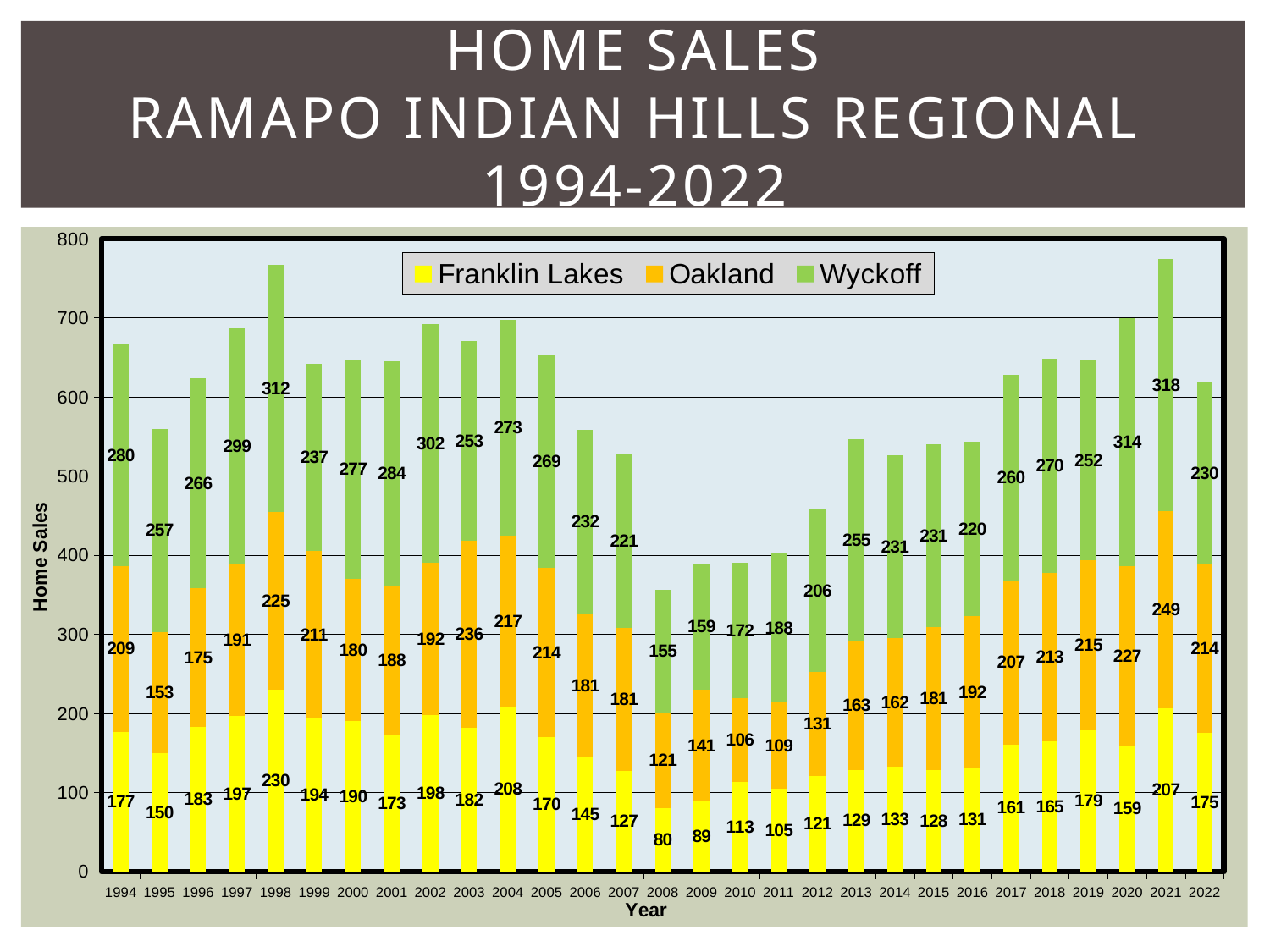
What is the value for Oakland in 2003? 236 What is the value for Wyckoff in 2020? 314 What is the difference between the Wyckoff values for 1998 and 2008? 157 What is the total of the stacked bar for 2021? 774 What type of chart is shown on the slide? stacked bar chart How many series does the legend list? 3 In which year is the Franklin Lakes value lowest? 2008 What is the value for Franklin Lakes in 1998? 230 In which year is the Wyckoff value highest? 2021 Which series is shown in yellow in the legend? Franklin Lakes Which is larger, the Oakland value in 2010 or the Oakland value in 2016? 2016 How many years are shown on the x axis? 29